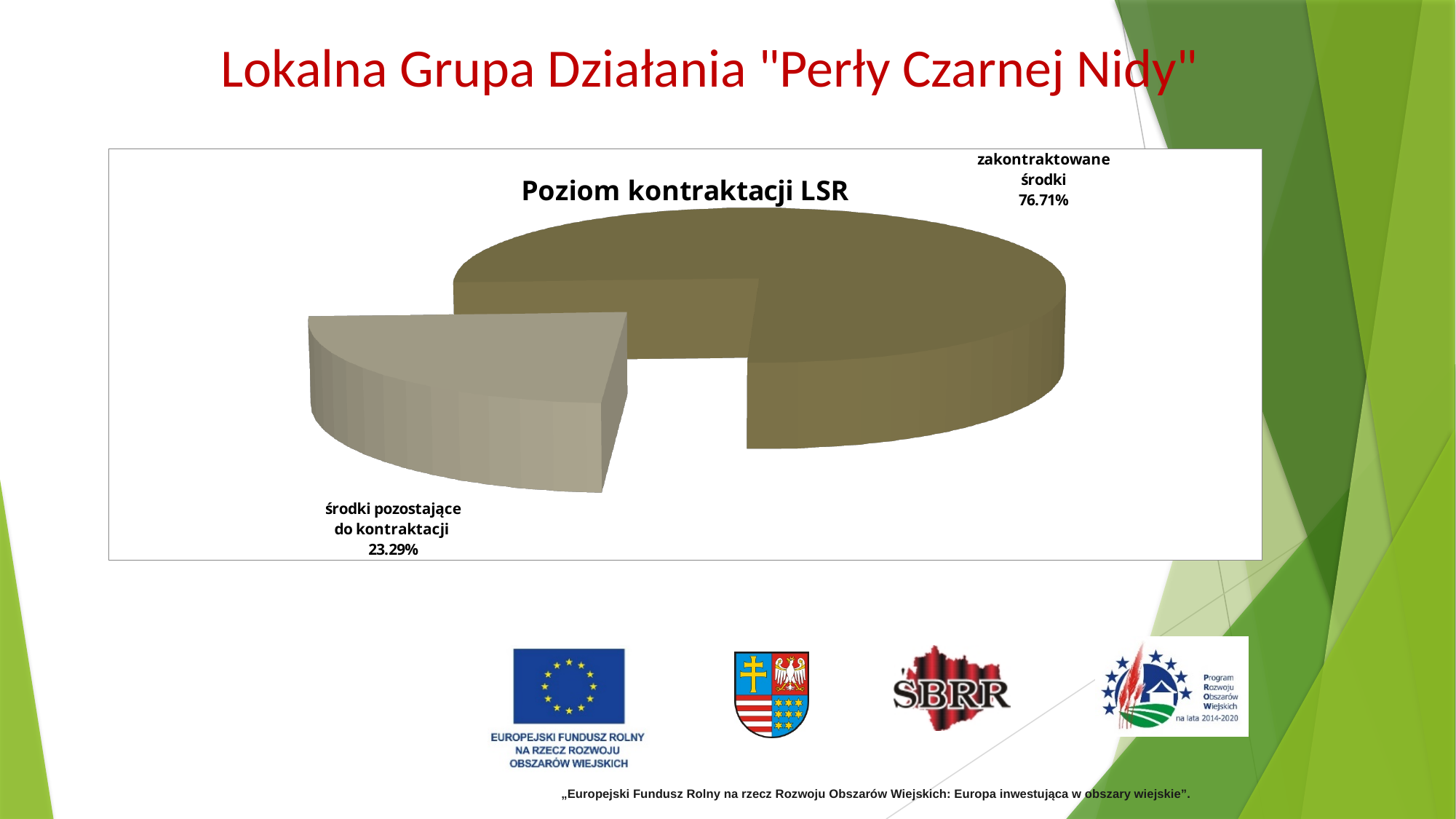
Is the share for "zakontraktowane środki" greater or less than 50%? greater How many slices does the pie chart have? 2 Which slice of the pie is the smallest? środki pozostające do kontraktacji What share of the pie is labelled "środki pozostające do kontraktacji"? 23.29% What kind of chart is shown on the slide? pie chart What is the title of the chart? Poziom kontraktacji LSR Which slice of the pie is pulled out (exploded) from the rest? środki pozostające do kontraktacji Which slice of the pie is the largest? zakontraktowane środki Which is larger: "zakontraktowane środki" or "środki pozostające do kontraktacji"? zakontraktowane środki What share of the pie is labelled "zakontraktowane środki"? 76.71% Is the share for "środki pozostające do kontraktacji" greater or less than 25%? less What is the difference in percentage points between "zakontraktowane środki" and "środki pozostające do kontraktacji"? 53.42